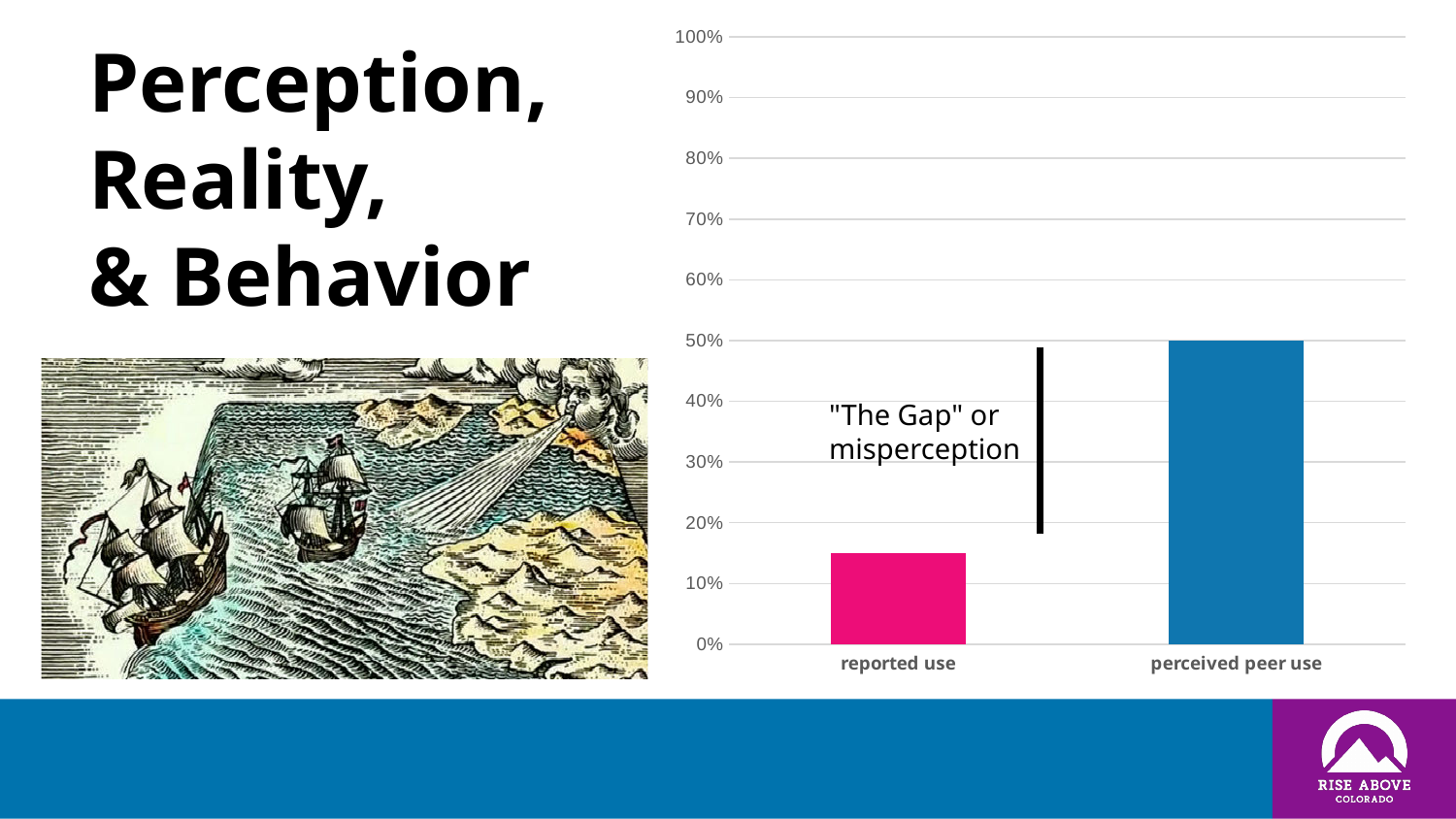
How many categories are plotted on the chart? 2 What type of chart is shown on the slide? bar chart What is the highest value shown on the y axis? 100% Is the value for reported use greater or less than 10%? greater Is the value for perceived peer use greater or less than 40%? greater Is the value for reported use greater or less than 20%? less What is the value for perceived peer use? 50% What text is written between the two bars on the chart? "The Gap" or misperception Which category has the lowest value on the chart? reported use Which category has the highest value on the chart? perceived peer use Which category has the higher value, reported use or perceived peer use? perceived peer use